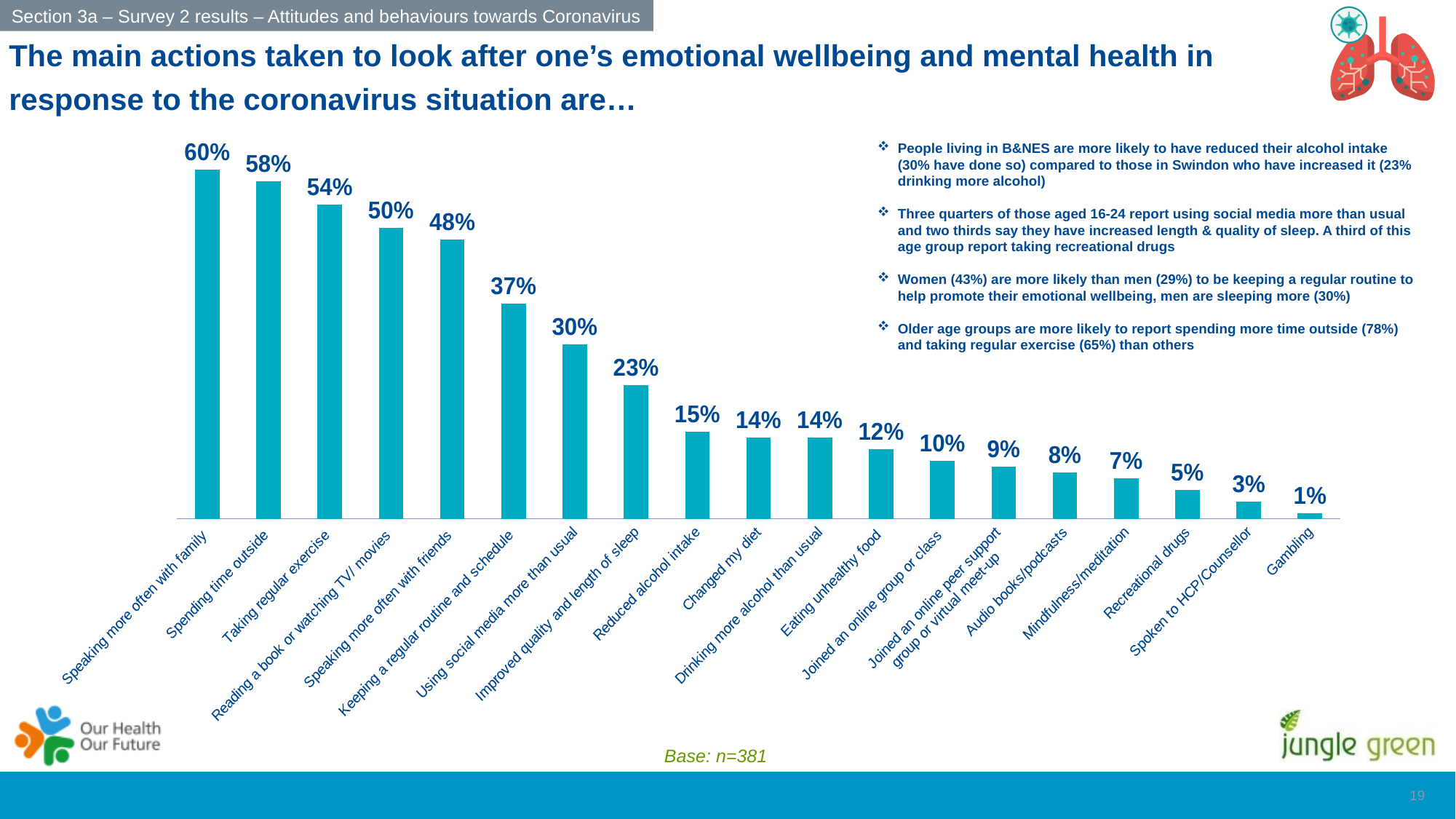
What is the difference between the percentages for 'Spending time outside' and 'Taking regular exercise'? 4% What percentage of respondents reported speaking more often with family? 60% How many actions (categories) are shown in the chart? 19 What is the base sample size stated below the chart? n=381 What is the difference between 'Using social media more than usual' and 'Improved quality and length of sleep'? 7% Do the values rise or fall moving from left to right along the x axis? Fall Which action has the lowest percentage in the chart? Gambling What type of chart is used on this slide? Bar chart Which is larger: the value for 'Reduced alcohol intake' or the value for 'Eating unhealthy food'? Reduced alcohol intake Which action has the highest percentage in the chart? Speaking more often with family What is the value shown for 'Keeping a regular routine and schedule'? 37% What percentage is shown for 'Mindfulness/meditation'? 7%